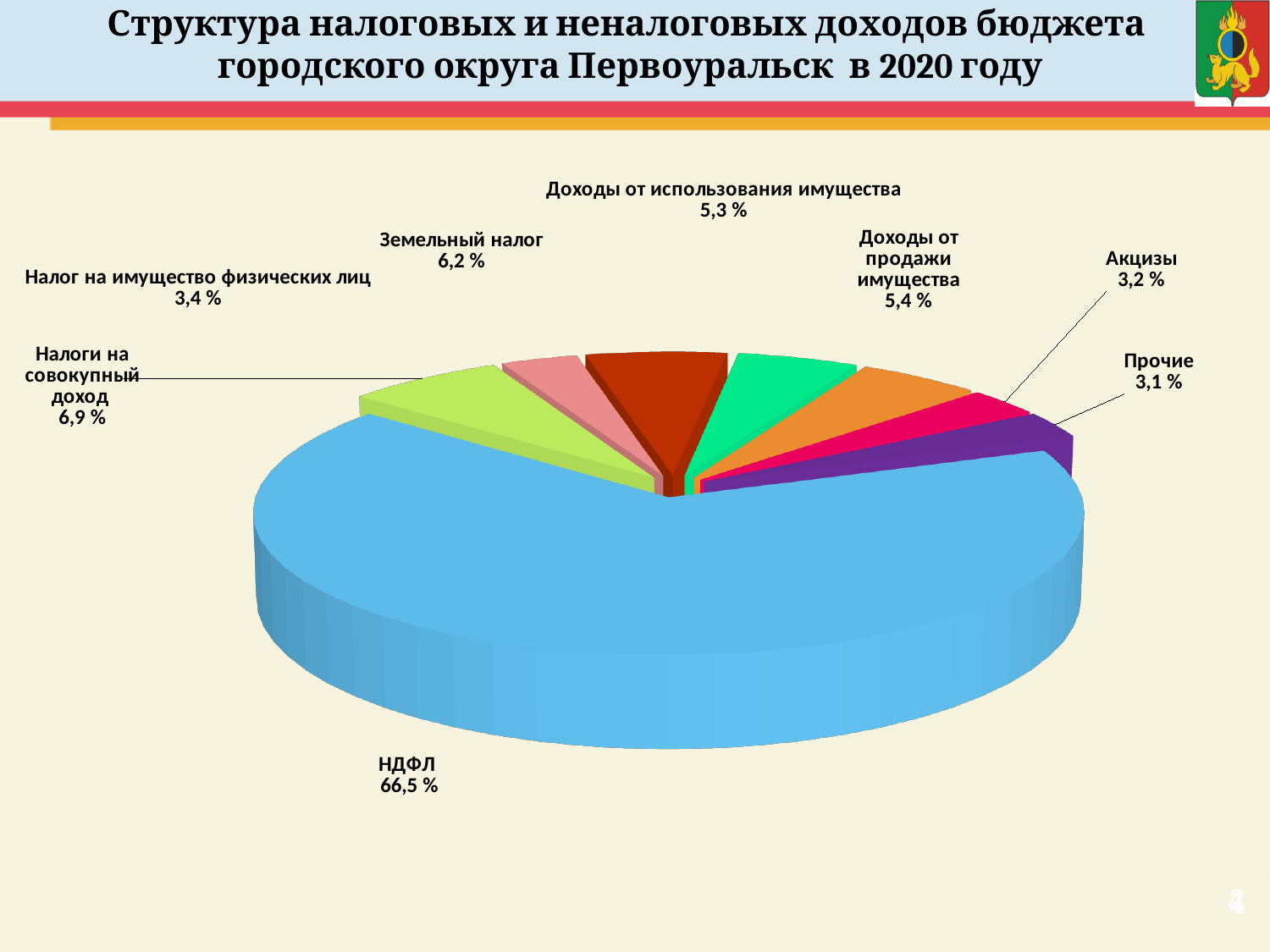
What kind of chart is shown on the slide? Pie chart What is the value shown for Доходы от продажи имущества? 5,4 % What share of the pie does НДФЛ account for? 66,5 % Which is larger, Доходы от продажи имущества or Доходы от использования имущества? Доходы от продажи имущества Which category has the smallest slice of the pie? Прочие What is the value shown for Налоги на совокупный доход? 6,9 % What is the title of the chart on the slide? Структура налоговых и неналоговых доходов бюджета городского округа Первоуральск в 2020 году How many slices does the pie chart have? 8 Which category has the largest slice of the pie? НДФЛ What is the difference between the values for Налоги на совокупный доход and Земельный налог? 0,7 % What is the value shown for Земельный налог? 6,2 % What is the value shown for Акцизы? 3,2 %